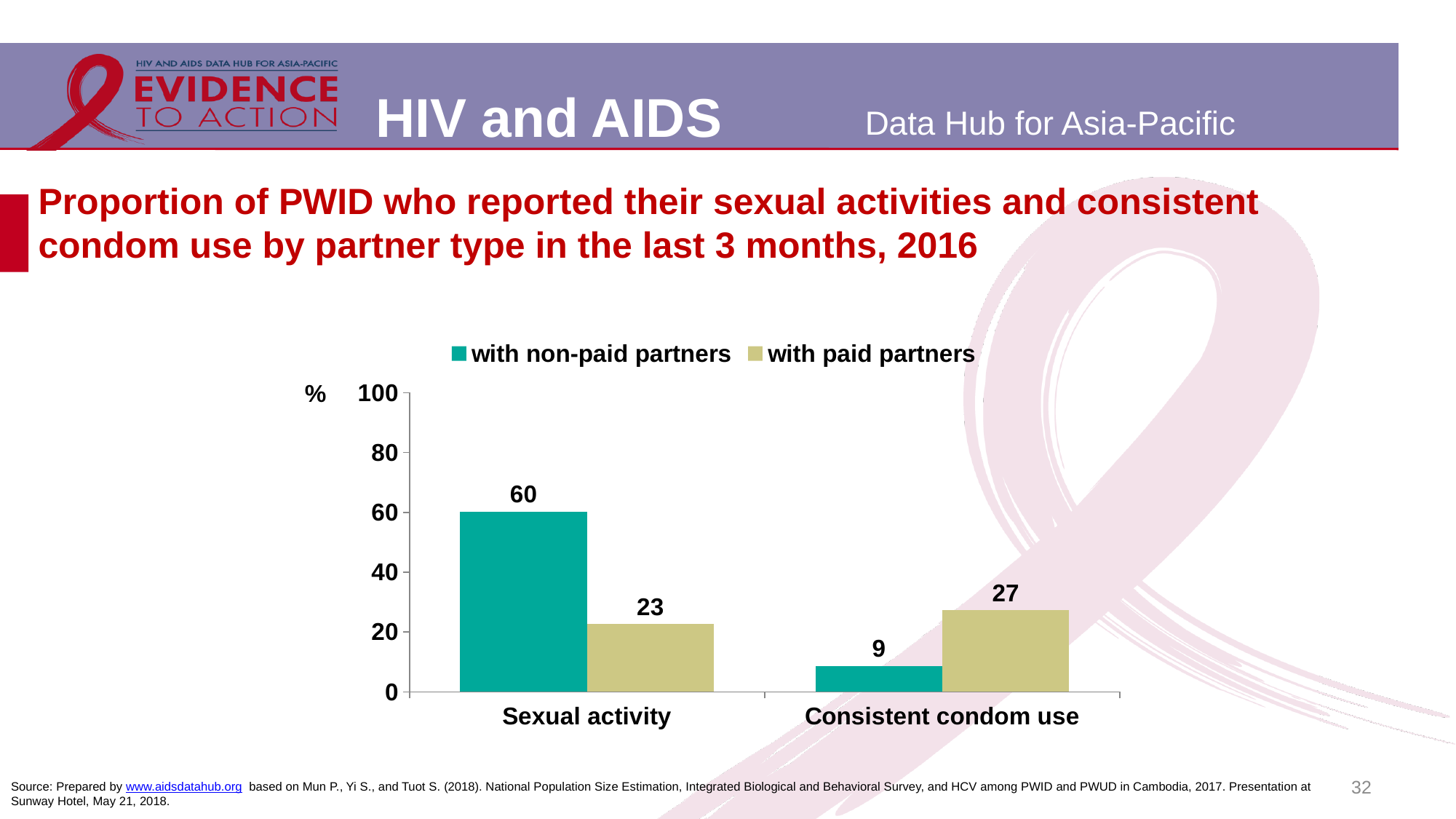
What is the difference between the 'with paid partners' and 'with non-paid partners' values for Consistent condom use? 18 What is the difference between the 'with non-paid partners' and 'with paid partners' values for Sexual activity? 37 What is the value for 'with paid partners' in the Consistent condom use category? 27 What kind of chart is shown on the slide? Bar chart Which bar has the highest value on the chart? Sexual activity, with non-paid partners How many series does the legend list? 2 For Consistent condom use, which is larger: the value with non-paid partners or with paid partners? with paid partners What is the value for 'with paid partners' in the Sexual activity category? 23 What is the value for 'with non-paid partners' in the Sexual activity category? 60 What is the value for 'with non-paid partners' in the Consistent condom use category? 9 How many categories are shown on the x axis? 2 Which bar has the lowest value on the chart? Consistent condom use, with non-paid partners